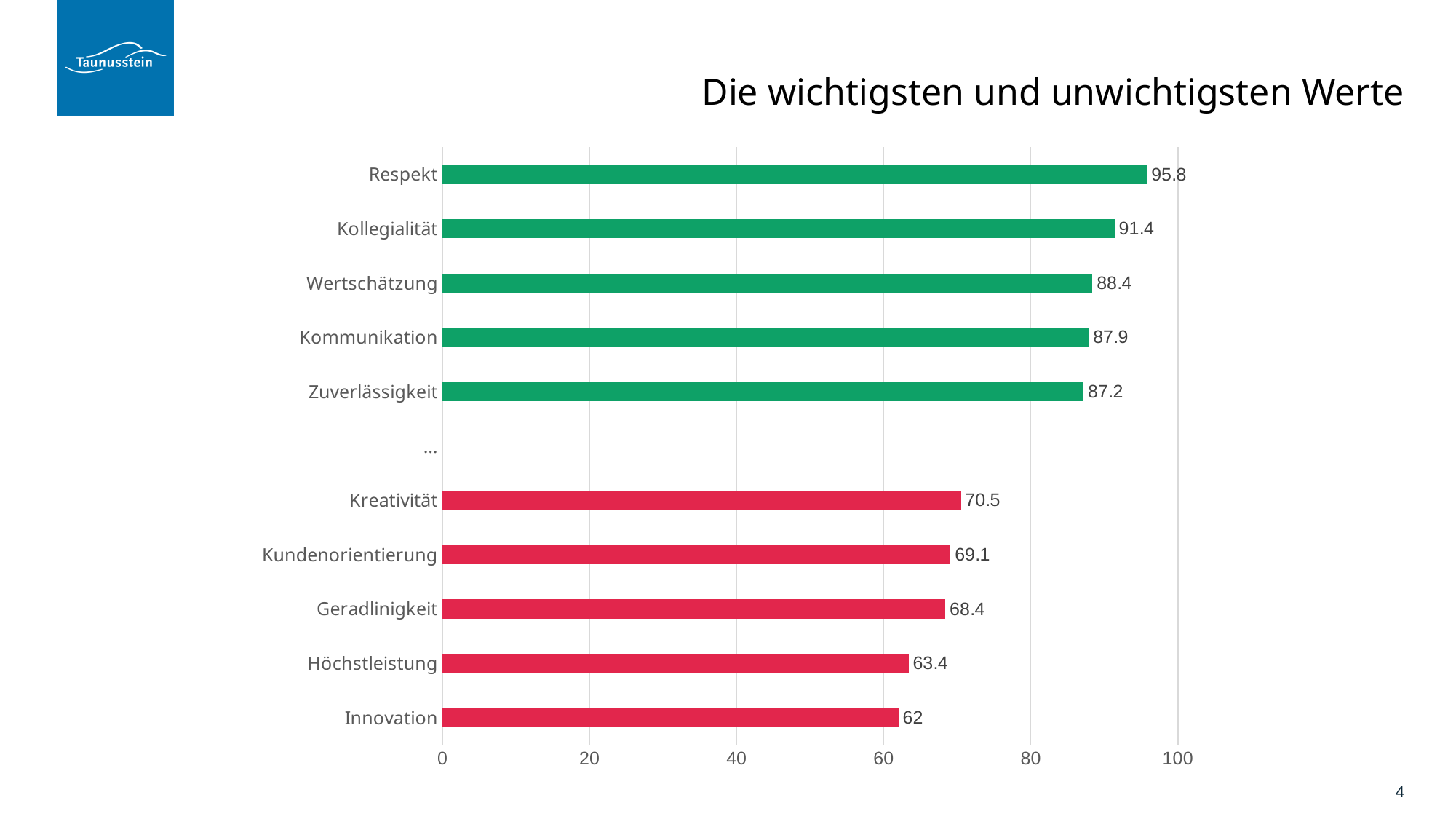
What is the difference between the values for Respekt and Innovation? 33.8 Which category has the highest value? Respekt Is the value for Zuverlässigkeit greater or less than 80? greater Which category has the lowest value? Innovation How many bars are plotted on the chart? 10 What kind of chart is shown on the slide? bar chart What is the value for Kundenorientierung? 69.1 What is the title of the slide? Die wichtigsten und unwichtigsten Werte What is the value for Innovation? 62 Which is larger, the value for Kreativität or the value for Höchstleistung? Kreativität What is the value for Respekt? 95.8 What is the difference between the values for Kollegialität and Wertschätzung? 3